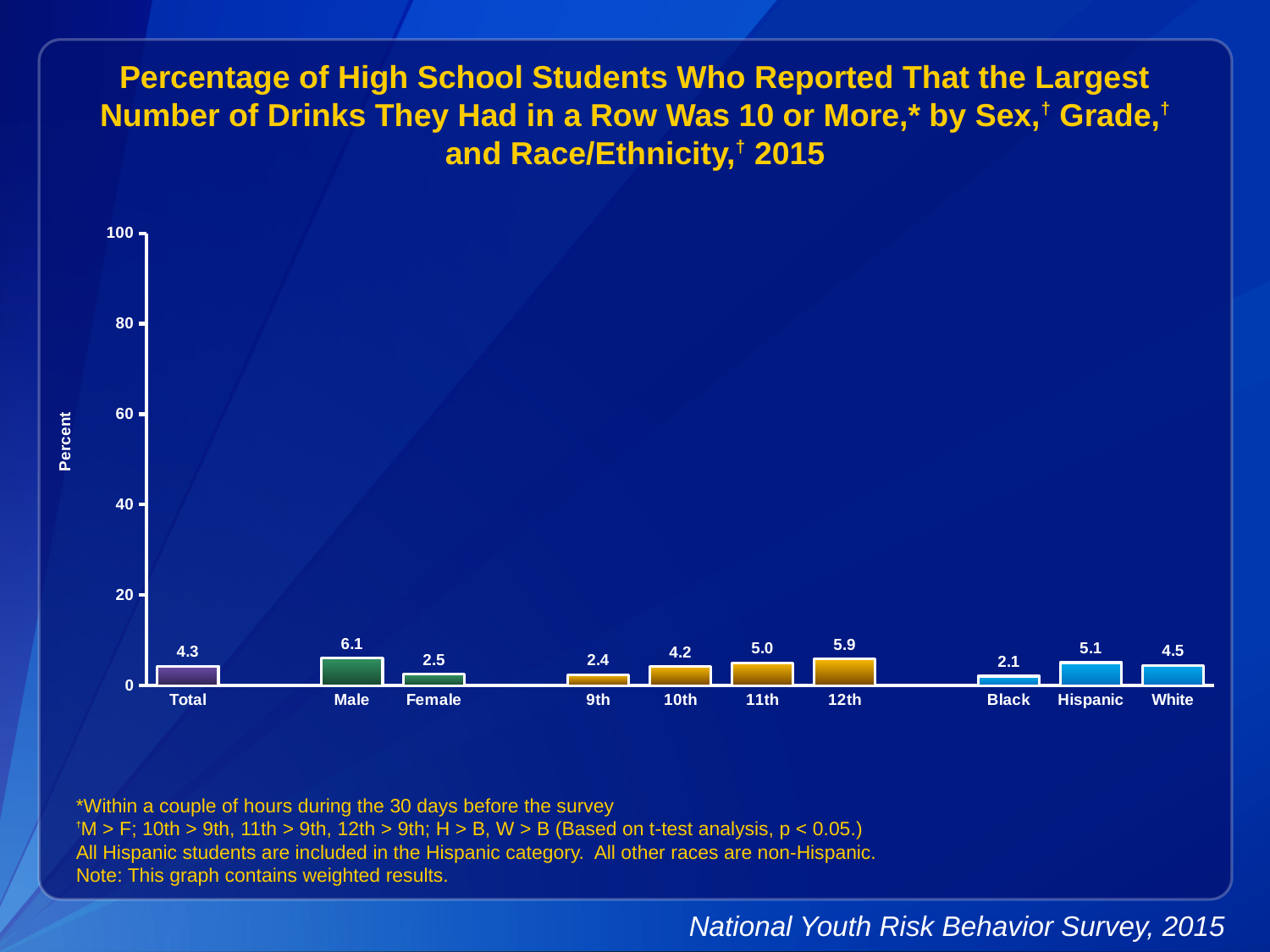
Which is larger, the value for Hispanic or the value for White? Hispanic What is the value for 9th grade? 2.4 Which category has the highest value? Male How many categories are shown on the x axis? 10 What is the value for Male? 6.1 What is the difference between the values for 12th grade and 9th grade? 3.5 What is the value for Black students? 2.1 What is the difference between the values for Male and Female? 3.6 What is the value for Total? 4.3 What kind of chart is this? bar chart Is the value for 12th grade greater or less than 20? less Which category has the lowest value? Black